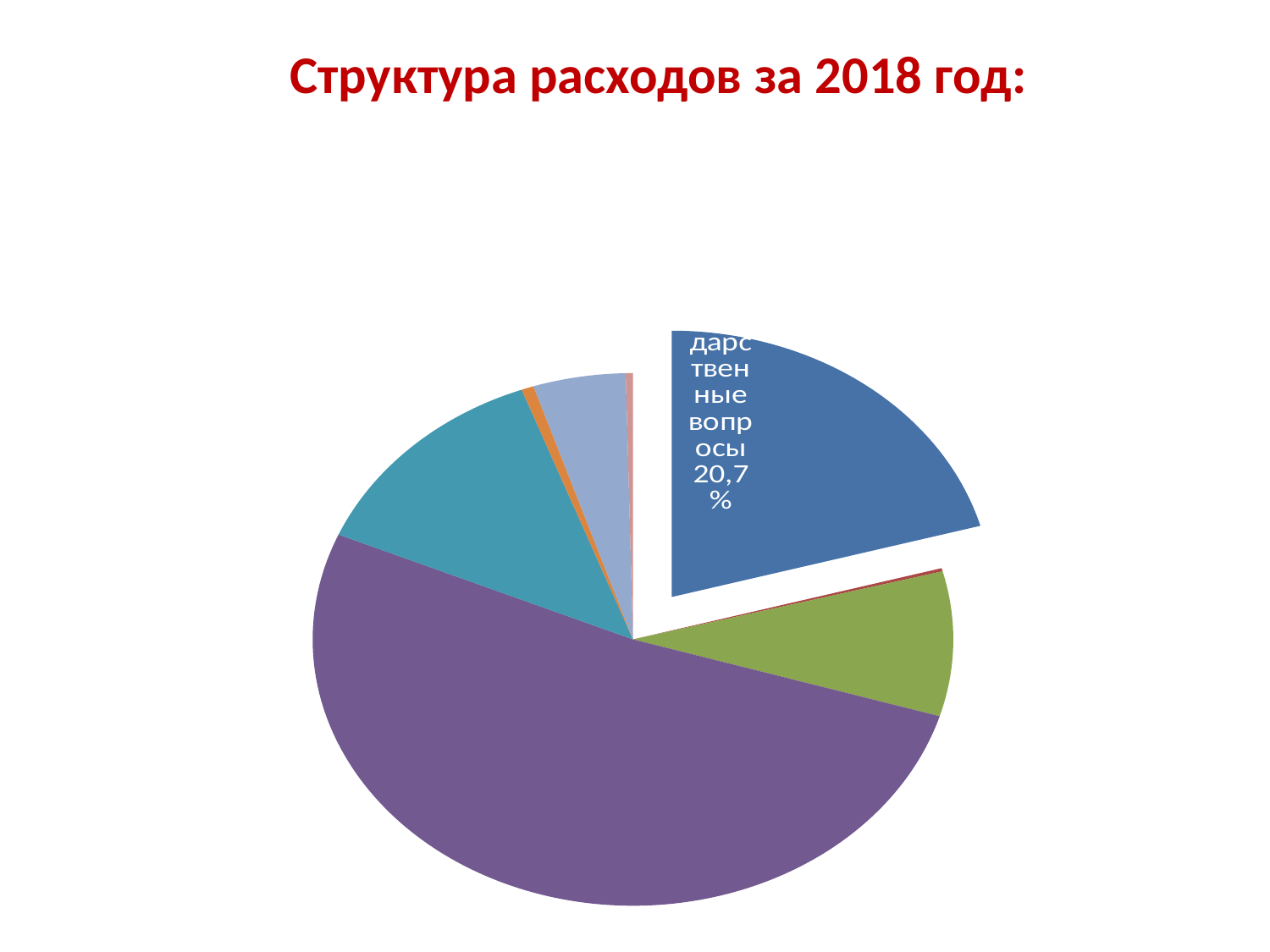
What kind of chart is shown on the slide? pie chart Which colour slice is the largest in the pie chart? purple Is the slice labelled '...дарственные вопросы' greater or less than 25% of the pie? less What share of the pie does the slice labelled '...дарственные вопросы' represent? 20,7% Which is larger, the green slice or the light lavender slice? the green slice What percentage is shown on the exploded blue slice labelled '...дарственные вопросы'? 20,7% Is the purple slice greater or less than 50% of the pie? greater Which is larger, the teal slice or the green slice? the teal slice Which slice of the pie is pulled out (exploded) from the rest? the blue slice labelled '...дарственные вопросы' (20,7%) Which is larger, the purple slice or the blue exploded slice? the purple slice What is the title of the chart on the slide? Структура расходов за 2018 год: